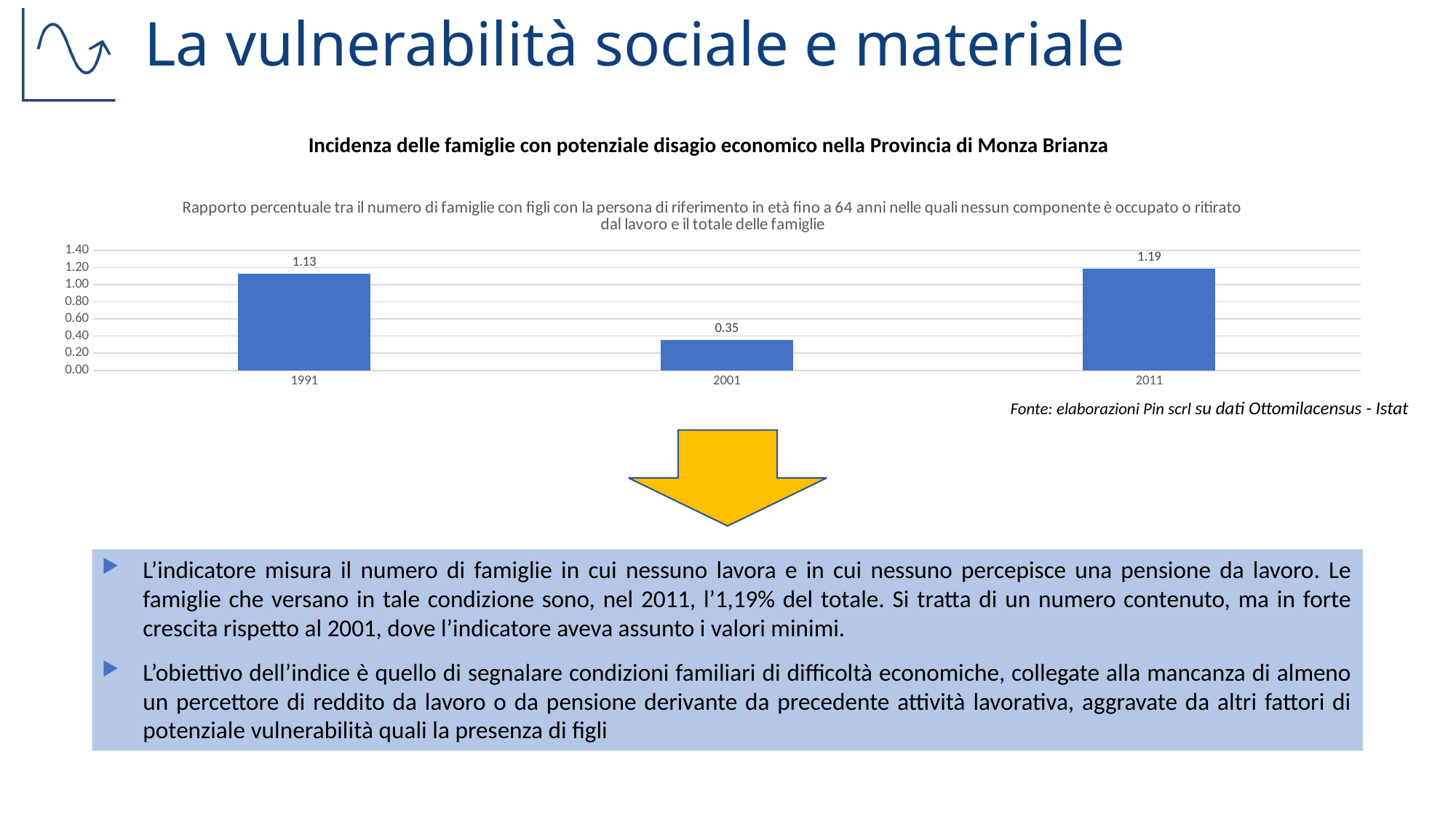
Which year has the highest value? 2011 What is the source cited below the chart? Fonte: elaborazioni Pin scrl su dati Ottomilacensus - Istat What is the difference between the values for 1991 and 2001? 0.78 What is the value for 2011? 1.19 What is the difference between the values for 2011 and 2001? 0.84 How many years are shown on the chart? 3 What is the value for 2001? 0.35 What kind of chart is shown on the slide? bar chart Which year has the lowest value? 2001 What is the value for 1991? 1.13 Which is larger, the value for 1991 or the value for 2001? 1991 Is the value for 2001 greater or less than 0.40? less